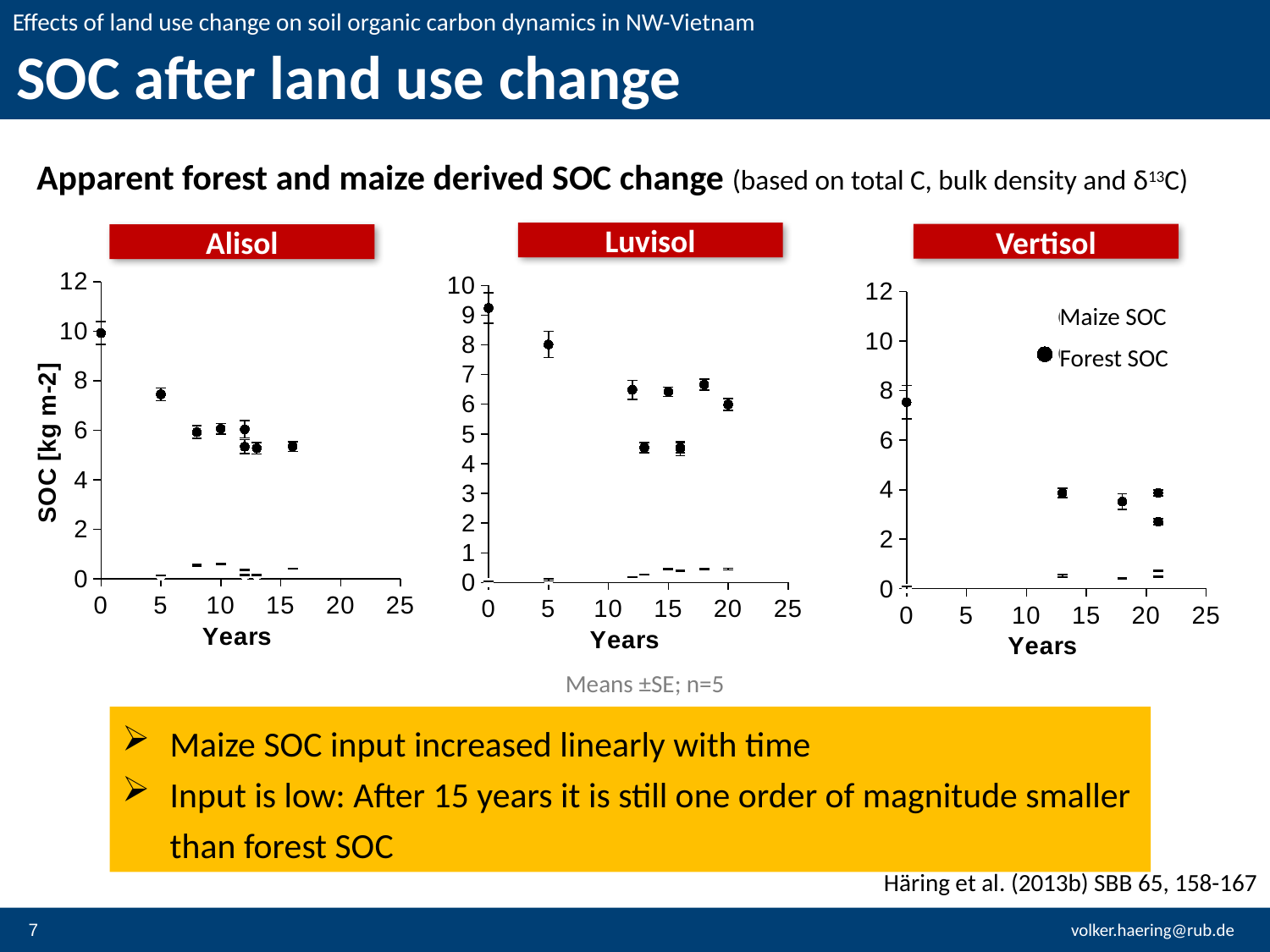
What is the y-axis label on the Alisol chart? SOC [kg m-2] In the Alisol chart, does Forest SOC rise or fall as Years increase? fall In the Vertisol chart, is the Forest SOC value at 0 years larger than the Forest SOC value at 18 years? yes How many charts are shown on the slide? 3 In the Vertisol chart, is the Forest SOC value at 0 years greater or less than 6? greater In the Alisol chart, is the Forest SOC value at 5 years greater or less than 6? greater In the Vertisol chart, does Forest SOC rise or fall as Years increase? fall What are the two series named in the legend on the Vertisol chart? Maize SOC and Forest SOC How many series does the legend on the Vertisol chart list? 2 What kind of chart is the Alisol chart? scatter chart In the Luvisol chart, is the Forest SOC value at 0 years greater or less than 8? greater In the Luvisol chart, does Maize SOC rise or fall as Years increase? rise